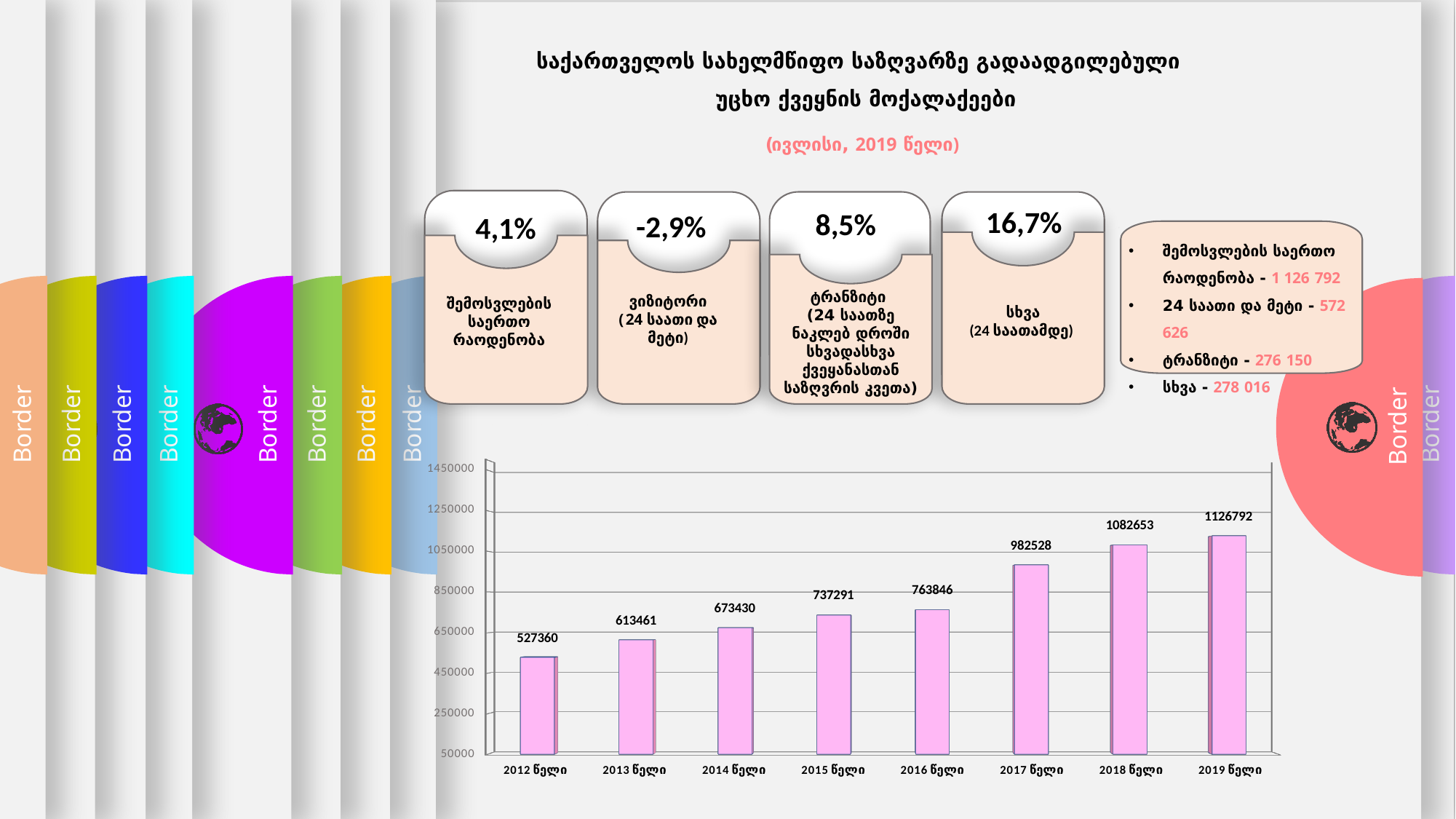
What is the difference between the values for 2019 წელი and 2018 წელი? 44139 What is the value shown for 2017 წელი in the bar chart? 982528 How many years (bars) are shown in the bar chart? 8 What is the difference between the values for 2013 წელი and 2012 წელი? 86101 What type of chart is shown at the bottom of the slide? bar chart Which is larger, the value for 2015 წელი or the value for 2016 წელი? 2016 წელი Which year has the lowest value in the bar chart? 2012 წელი Which year has the highest value in the bar chart? 2019 წელი What is the value shown for 2012 წელი in the bar chart? 527360 Do the values in the bar chart rise or fall from 2012 to 2019? rise What is the value shown for 2019 წელი in the bar chart? 1126792 Is the value for 2012 წელი greater or less than 650000? less